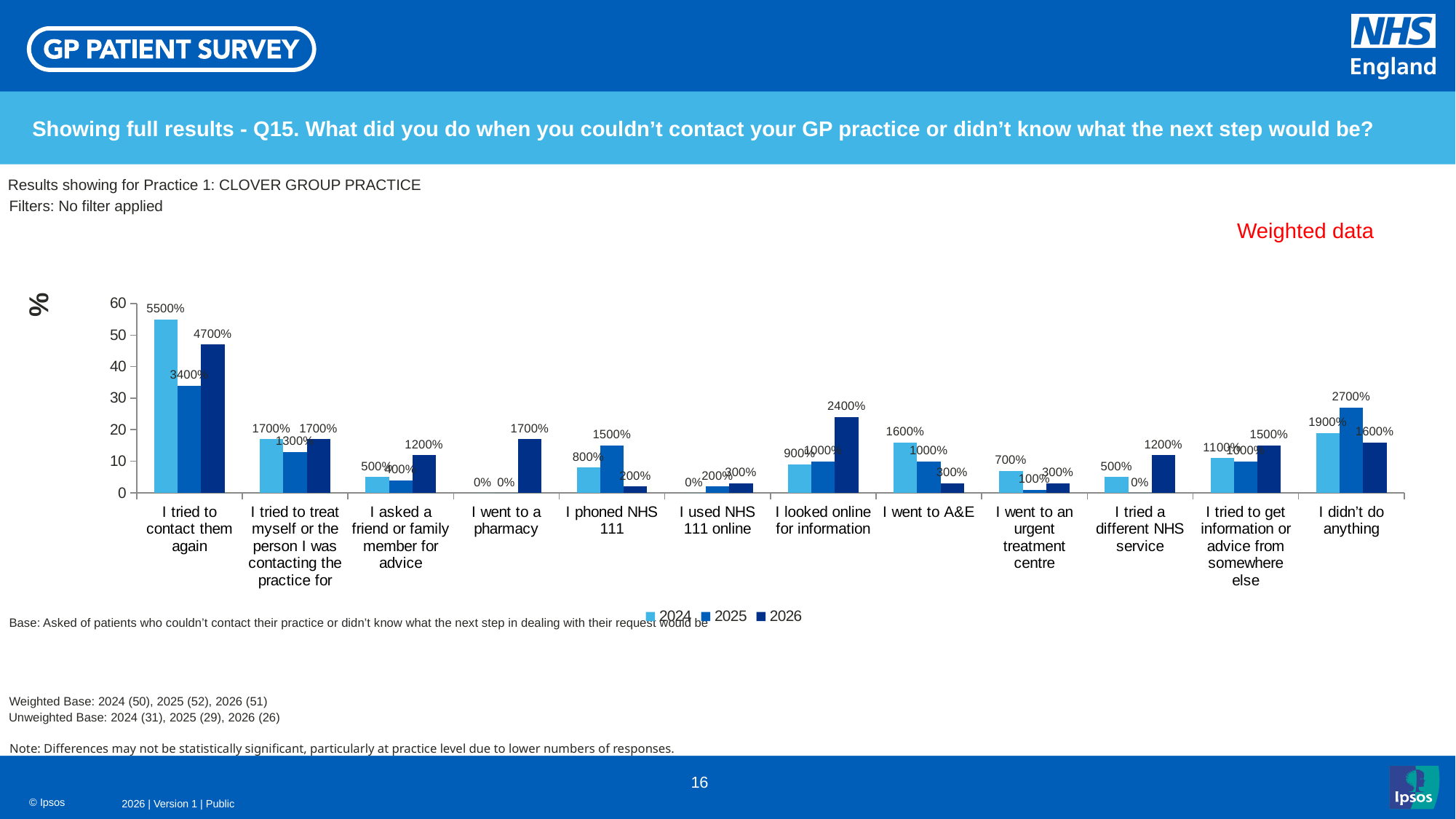
How many series does the legend list? 3 How many categories are shown on the x axis? 12 What is the 2026 value for 'I went to a pharmacy'? 1700% What is the difference between the 2024 and 2026 values for 'I tried to contact them again'? 800% What is the 2026 value for 'I looked online for information'? 2400% What is the 2025 value for 'I didn't do anything'? 2700% What is the 2024 value for 'I tried to contact them again'? 5500% For 'I went to A&E', which is larger, the 2024 value or the 2026 value? 2024 Which series is shown in the darkest blue in the legend? 2026 What kind of chart is shown on the slide? bar chart Which category has the highest 2024 value? I tried to contact them again Which category has the lowest 2026 value? I phoned NHS 111